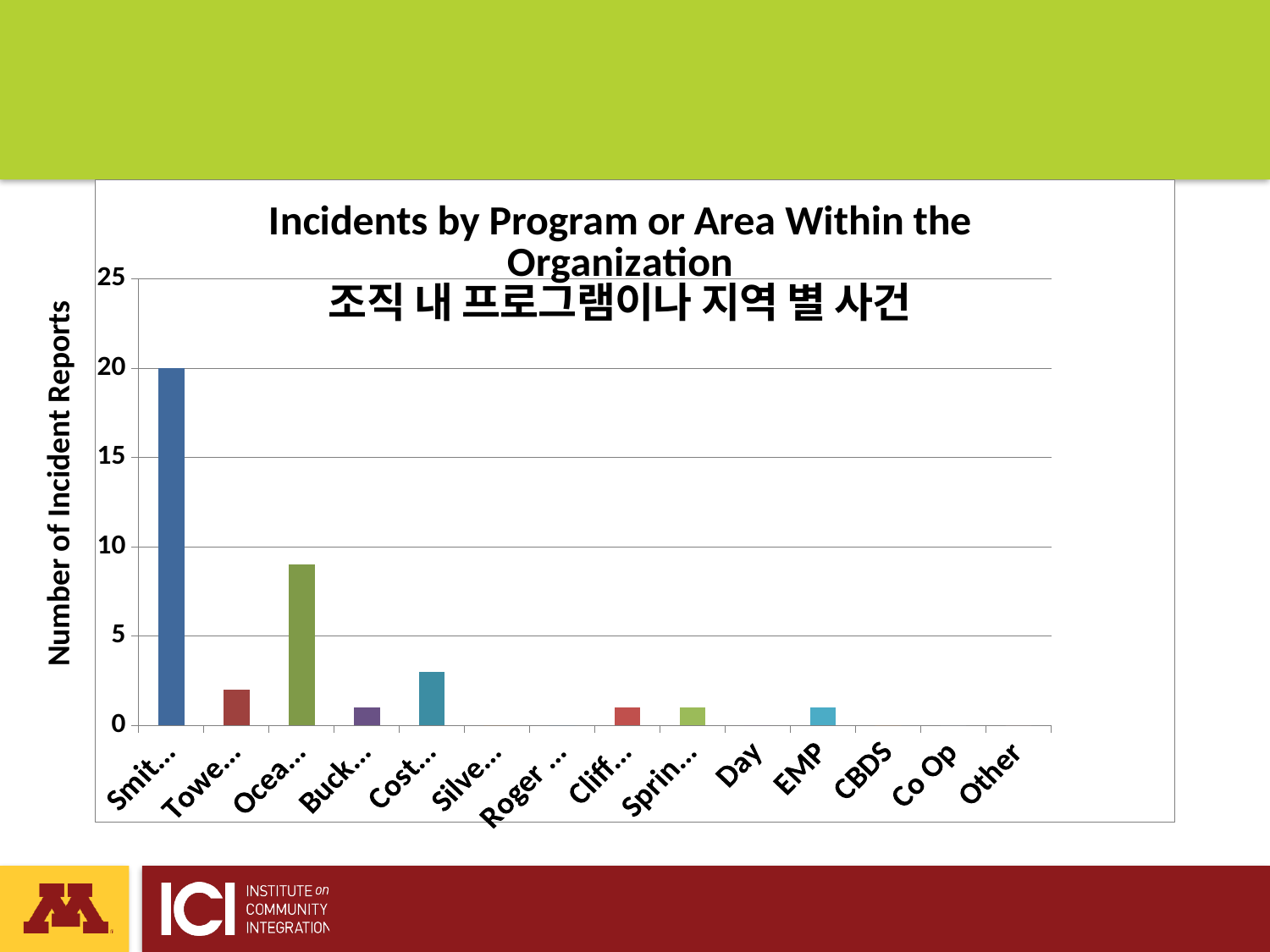
What is the English title of the chart? Incidents by Program or Area Within the Organization What kind of chart is shown on the slide? bar chart How many categories on the x axis have no visible bar (a value of 0)? 6 Which category has the highest bar in the chart? Smit... What is the label of the vertical axis? Number of Incident Reports Is the value for 'Smit...' greater or less than 15? greater How many categories are shown along the x axis of the chart? 14 What is the number of incident reports for Day? 0 What is the value of the first bar (labelled 'Smit...')? 20 Which has the larger value, 'Towe...' or 'Cost...'? Cost... Is the value for EMP greater or less than 5? less Is the value for 'Ocea...' greater or less than 10? less